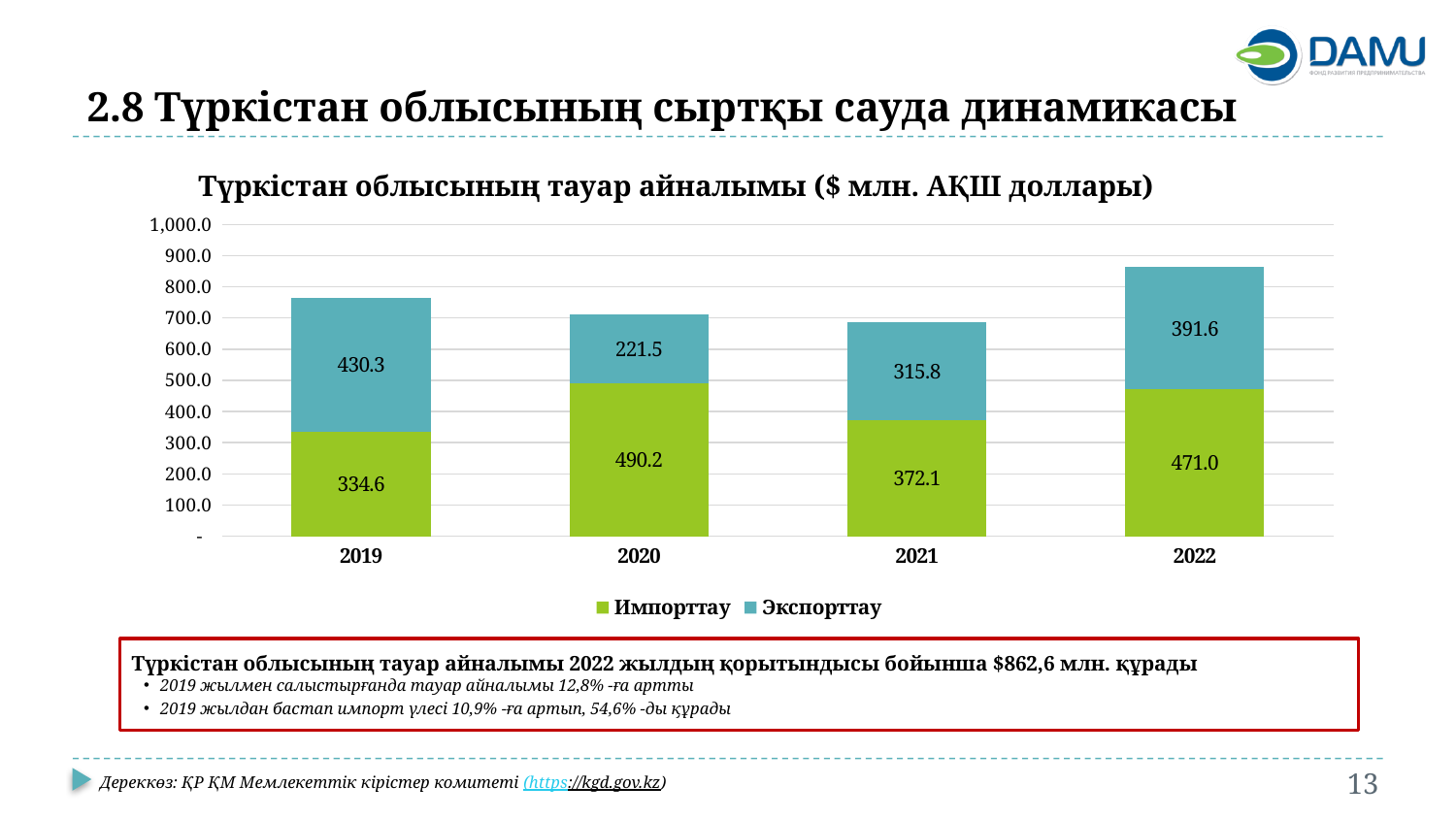
What is the Экспорттау value for 2019? 430.3 What is the Экспорттау value for 2022? 391.6 What is the difference between the Импорттау values for 2022 and 2021? 98.9 What is the total of the stacked bar for 2022? 862.6 What is the title of the chart? Түркістан облысының тауар айналымы ($ млн. АҚШ доллары) Which is larger in 2019, the Импорттау value or the Экспорттау value? Экспорттау Which year has the highest Импорттау value? 2020 Which year has the lowest Экспорттау value? 2020 How many series does the legend list? 2 What kind of chart is shown on the slide? Stacked bar chart What is the Импорттау value for 2020? 490.2 How many years are shown on the x axis? 4